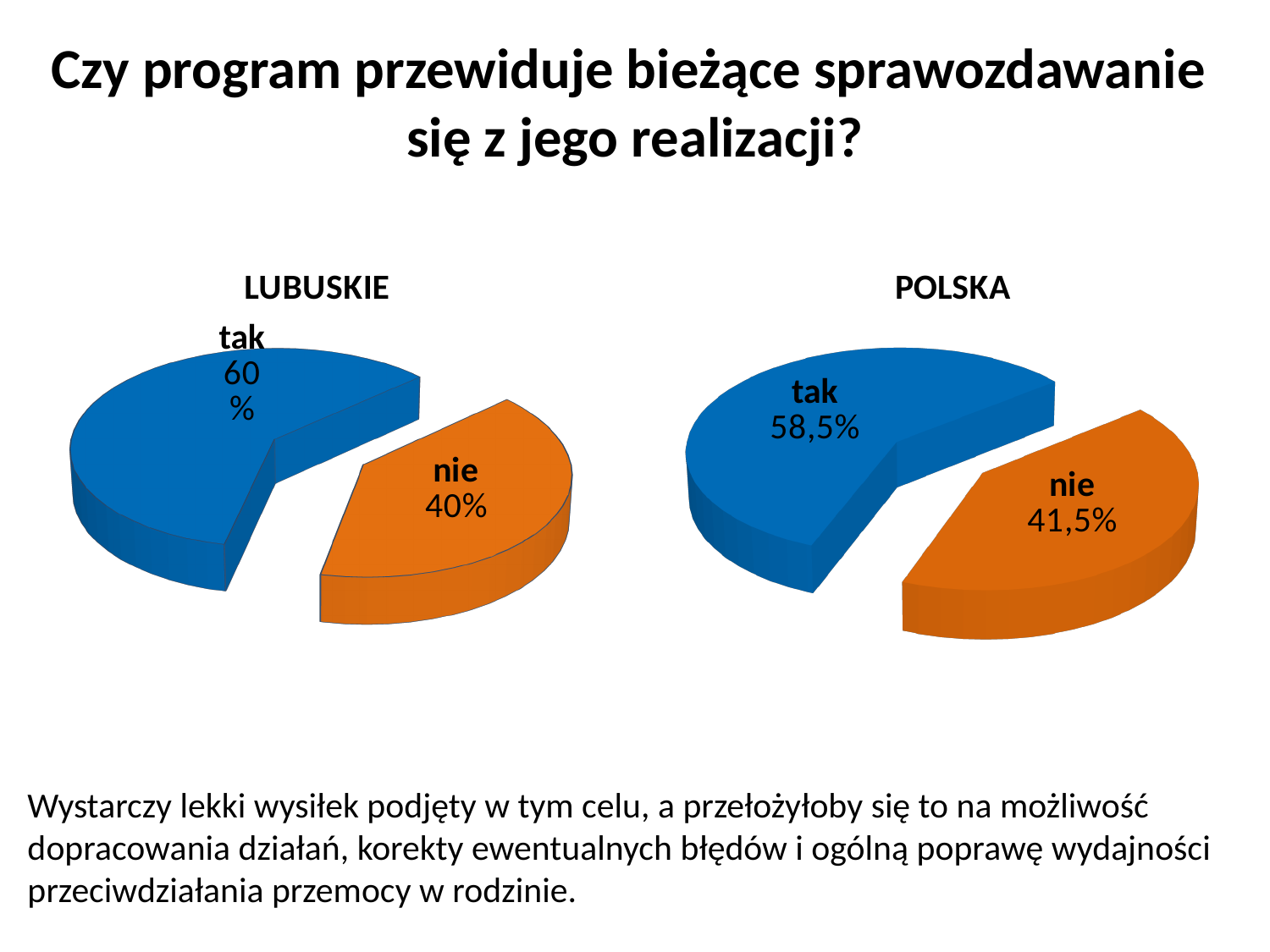
In the POLSKA chart, which slice is the smallest? nie What kind of chart is the LUBUSKIE chart? pie chart In the POLSKA chart, what share of the pie is labelled "nie"? 41,5% In the POLSKA chart, what share of the pie is labelled "tak"? 58,5% Which chart has the larger "tak" share, LUBUSKIE or POLSKA? LUBUSKIE How many slices does the POLSKA pie chart have? 2 In the LUBUSKIE chart, what is the difference between the "tak" and "nie" shares? 20% In the POLSKA chart, what is the difference between the "tak" and "nie" shares? 17% In the POLSKA chart, what colour is the "nie" slice? orange In the LUBUSKIE chart, what share of the pie is labelled "nie"? 40% In the LUBUSKIE chart, what share of the pie is labelled "tak"? 60% In the LUBUSKIE chart, which slice is the largest? tak